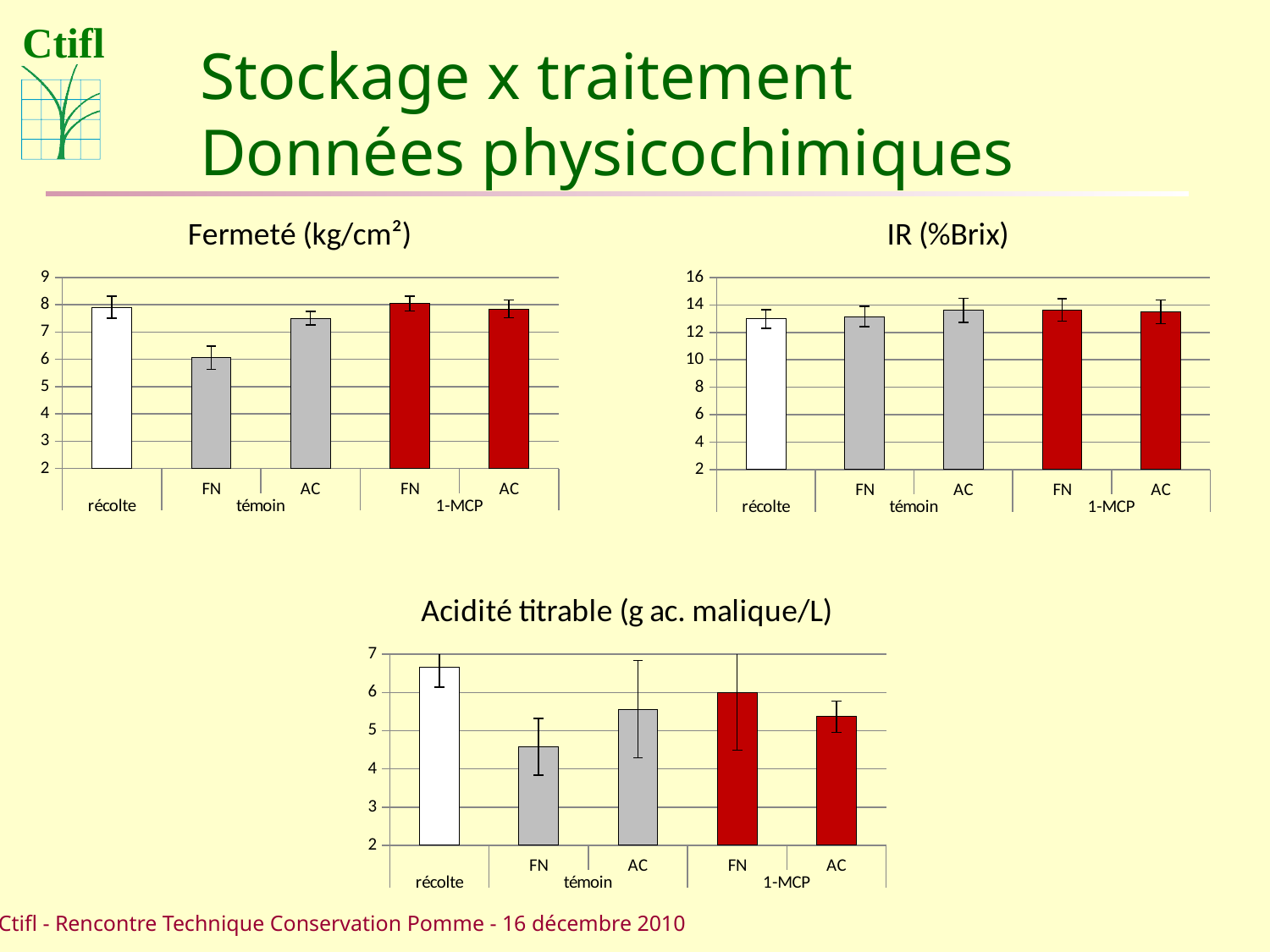
In the 'Fermeté (kg/cm²)' chart, is the value for témoin FN greater or less than 7? less In the 'Acidité titrable (g ac. malique/L)' chart, which bar is the highest? récolte How many bars are plotted in the 'IR (%Brix)' chart? 5 What is the title of the chart at the bottom of the slide? Acidité titrable (g ac. malique/L) In the 'Acidité titrable (g ac. malique/L)' chart, is the value for témoin FN greater or less than 5? less In the 'Fermeté (kg/cm²)' chart, which bar is the lowest? témoin FN In the 'Acidité titrable (g ac. malique/L)' chart, which bar is the lowest? témoin FN In the 'IR (%Brix)' chart, is the value for 1-MCP FN greater or less than 14? less What kind of chart is the 'Fermeté (kg/cm²)' chart? bar chart In the 'Fermeté (kg/cm²)' chart, which is larger, témoin FN or témoin AC? témoin AC